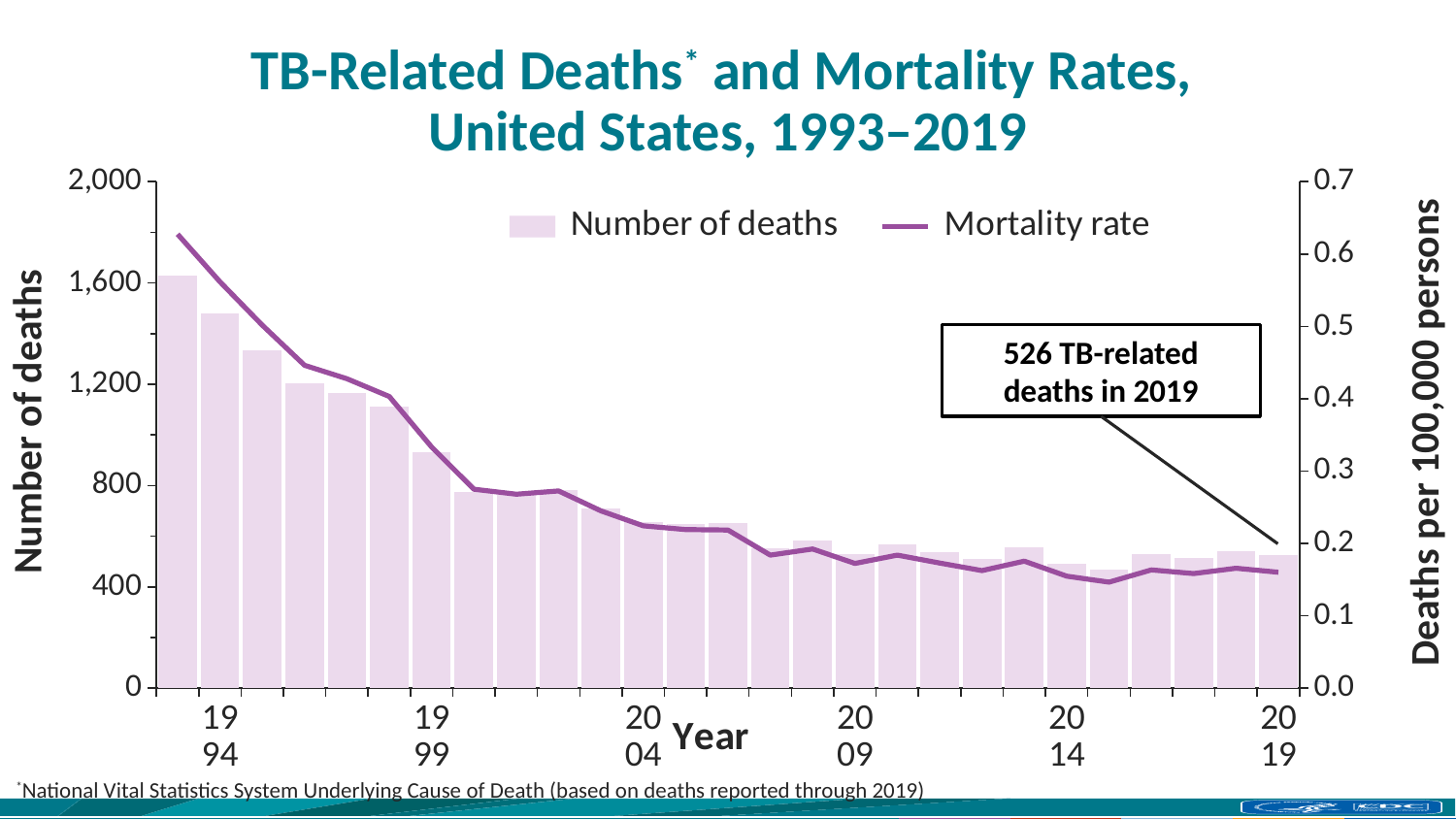
How many TB-related deaths were there in 2019? 526 What kind of chart is this? A bar chart combined with a line chart Is the number of deaths in 1994 greater or less than 1,200? greater How many years are plotted in the chart? 27 Is the mortality rate in 1994 greater or less than 0.4 deaths per 100,000 persons? greater How many series does the legend list? 2 Is the number of deaths in 2019 greater or less than 800? less Which year had a higher mortality rate, 2004 or 2014? 2004 Do the number of deaths rise or fall from 1993 to 2019? Fall What is the label of the right-hand vertical axis? Deaths per 100,000 persons Which year had more TB-related deaths, 1999 or 2009? 1999